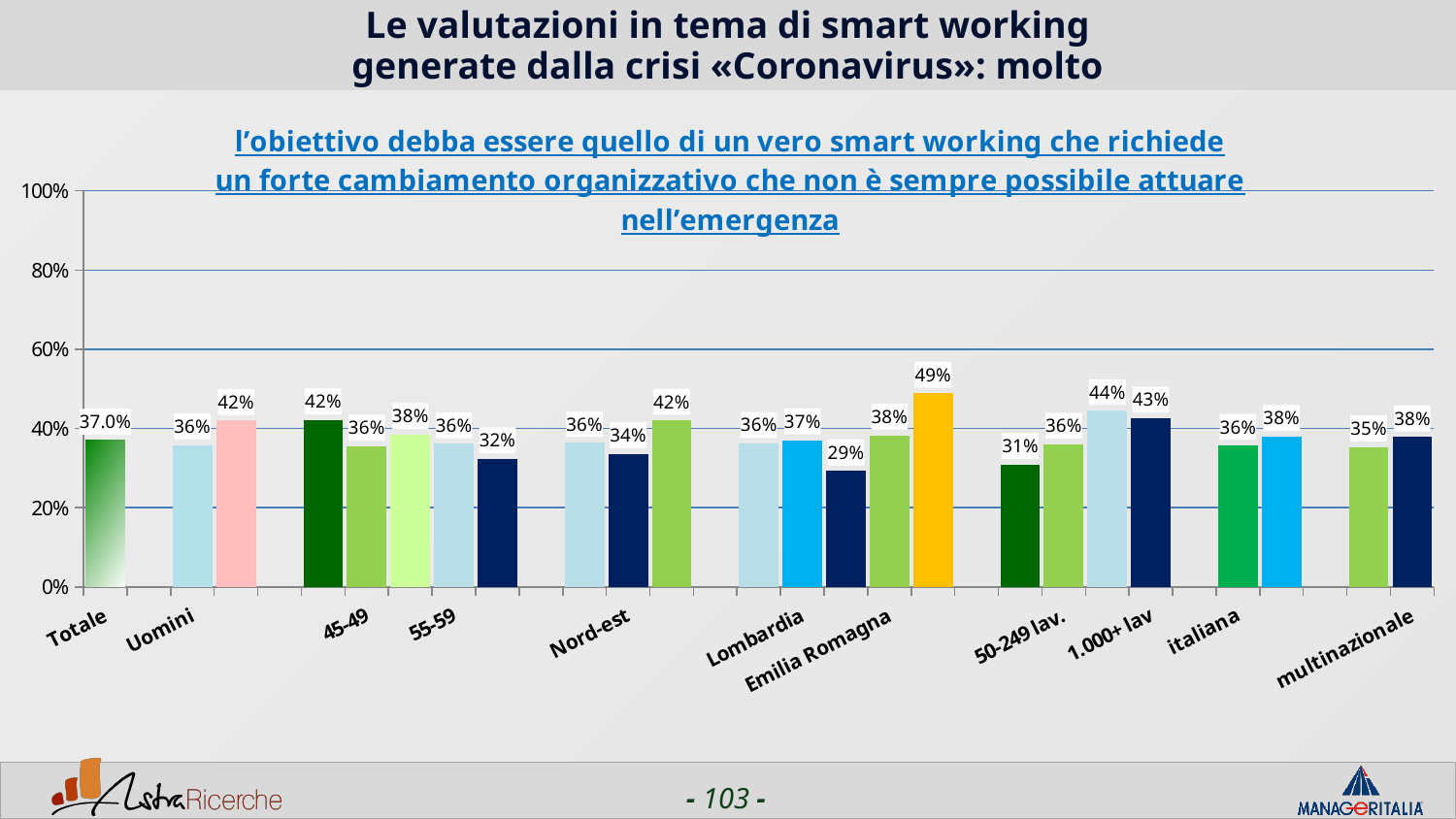
What is the highest value labelled on any bar in the chart? 49% What is the value for Uomini? 36% What is the difference between the values for 1.000+ lav and 50-249 lav.? 7 percentage points Is the value for Totale greater or less than 40%? less Which has the larger value, Nord-est or Emilia Romagna? Emilia Romagna Which has the larger value, multinazionale or italiana? multinazionale What kind of chart is shown on the slide? bar chart What is the value for Emilia Romagna? 38% What is the value for Totale? 37.0% What is the value for Nord-est? 34% What is the value for Lombardia? 37% What is the value for 1.000+ lav? 43%